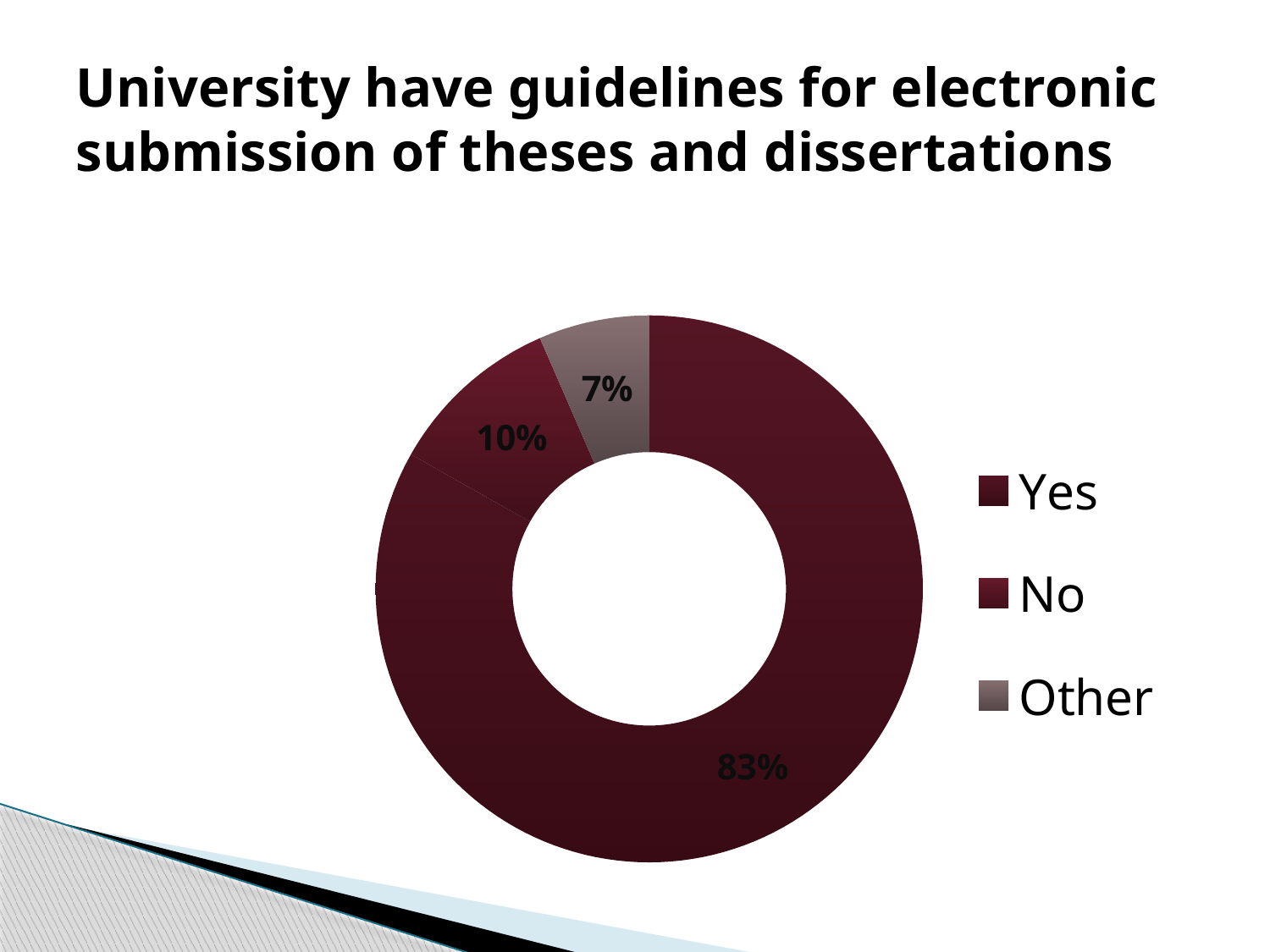
How many categories does the chart show? 3 What is the title of the slide? University have guidelines for electronic submission of theses and dissertations Which slice is larger, No or Other? No What percentage of the doughnut chart is labelled Other? 7% What percentage of the doughnut chart is labelled Yes? 83% What percentage of the doughnut chart is labelled No? 10% What kind of chart is shown on the slide? Doughnut (pie) chart Which legend entry is shown in grey? Other What is the difference in percentage points between the No and Other slices? 3 Which category has the largest share of the chart? Yes What is the difference in percentage points between the Yes and No slices? 73 Which category has the smallest share of the chart? Other